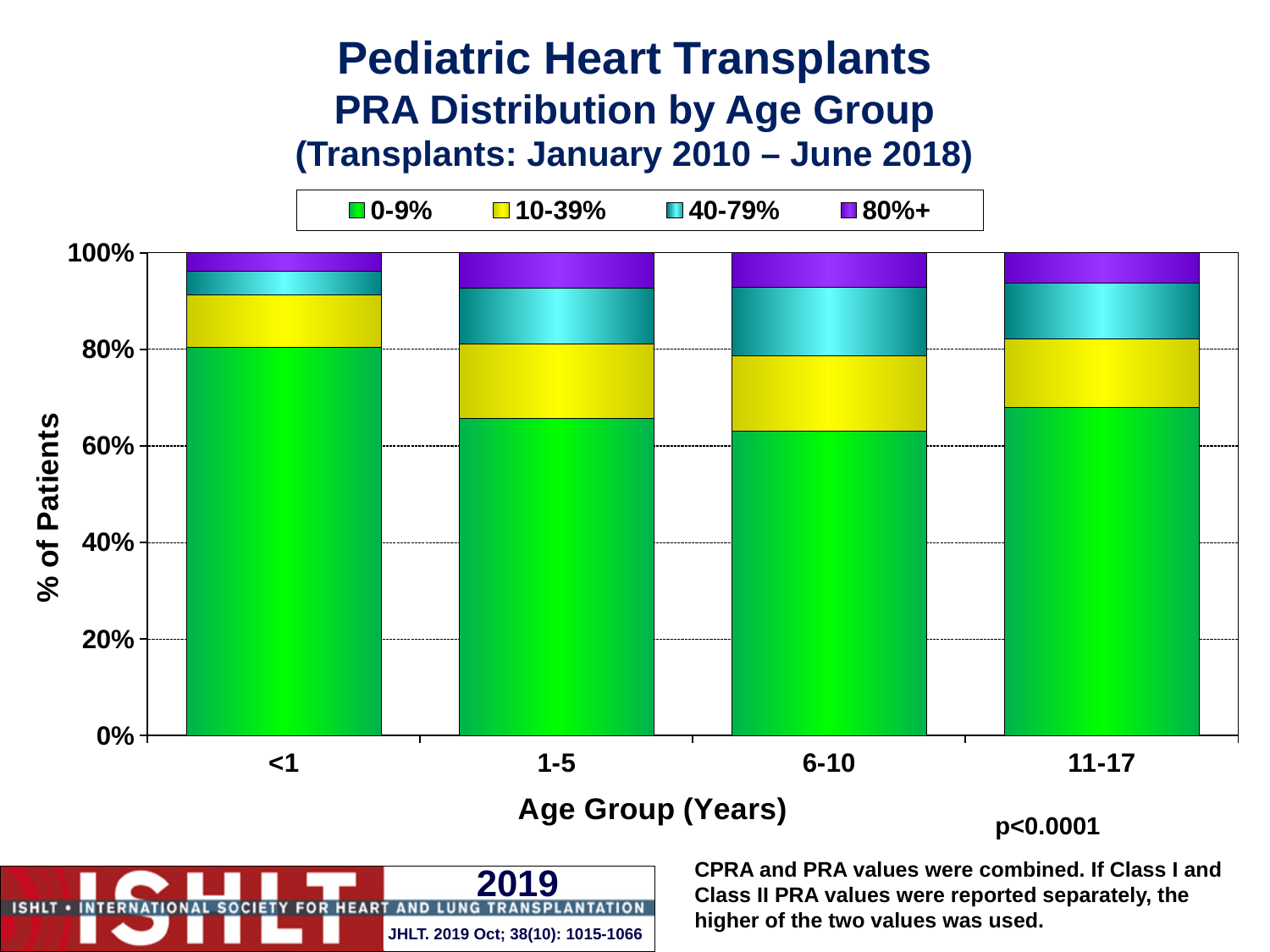
Which age group has the largest 0-9% PRA segment? <1 What is the label of the y axis? % of Patients Does the 0-9% PRA share rise or fall from the <1 age group to the 1-5 age group? fall How many age groups are shown on the x axis? 4 Is the 0-9% PRA share for the <1 age group greater or less than 60%? greater Which age group has the smallest 80%+ PRA segment? <1 What p-value is printed on the slide? p<0.0001 Is the 0-9% PRA share for the 6-10 age group greater or less than 80%? less How many series does the legend list? 4 What kind of chart is shown on the slide? Stacked bar chart Which age group has the smallest 40-79% PRA segment? <1 Is the 80%+ PRA segment larger for the 1-5 age group or the <1 age group? 1-5